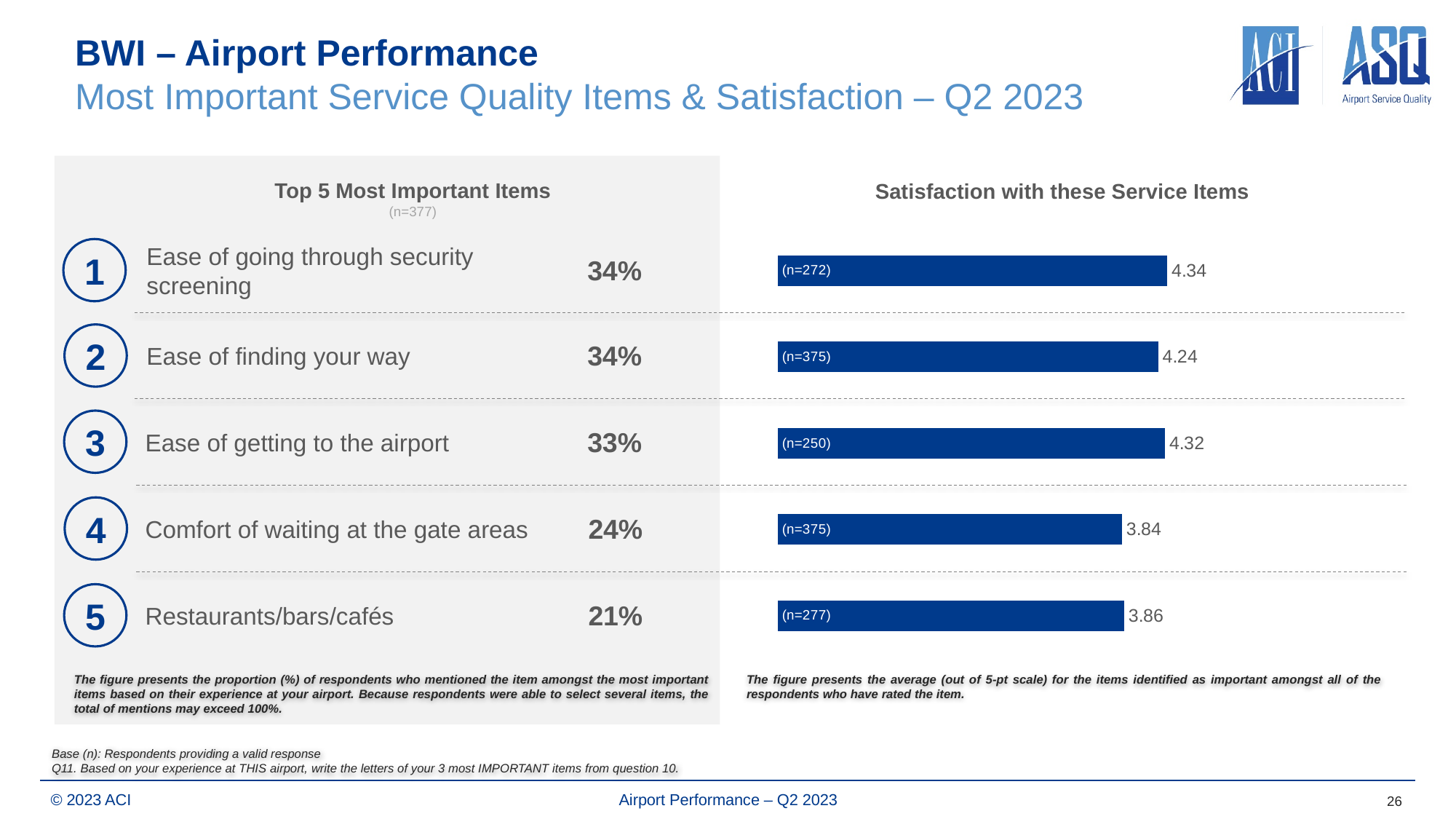
In the 'Top 5 Most Important Items' list, what is the difference between the percentages for Ease of getting to the airport and Comfort of waiting at the gate areas? 9% In the 'Satisfaction with these Service Items' chart, which item has the lowest satisfaction score? Comfort of waiting at the gate areas How many bars are shown in the 'Satisfaction with these Service Items' chart? 5 What kind of chart is 'Satisfaction with these Service Items'? Bar chart In the 'Satisfaction with these Service Items' chart, what is the satisfaction score for Comfort of waiting at the gate areas? 3.84 In the 'Satisfaction with these Service Items' chart, what is the base (n) shown on the bar for Ease of getting to the airport? n=250 In the 'Satisfaction with these Service Items' chart, what is the satisfaction score for Restaurants/bars/cafés? 3.86 In the 'Satisfaction with these Service Items' chart, what is the satisfaction score for Ease of going through security screening? 4.34 In the 'Satisfaction with these Service Items' chart, what is the difference between the satisfaction scores for Ease of going through security screening and Comfort of waiting at the gate areas? 0.50 In the 'Satisfaction with these Service Items' chart, which item has the highest satisfaction score? Ease of going through security screening In the 'Top 5 Most Important Items' list, what percentage of respondents mentioned Restaurants/bars/cafés? 21% In the 'Satisfaction with these Service Items' chart, which has a higher satisfaction score: Ease of finding your way or Ease of getting to the airport? Ease of getting to the airport